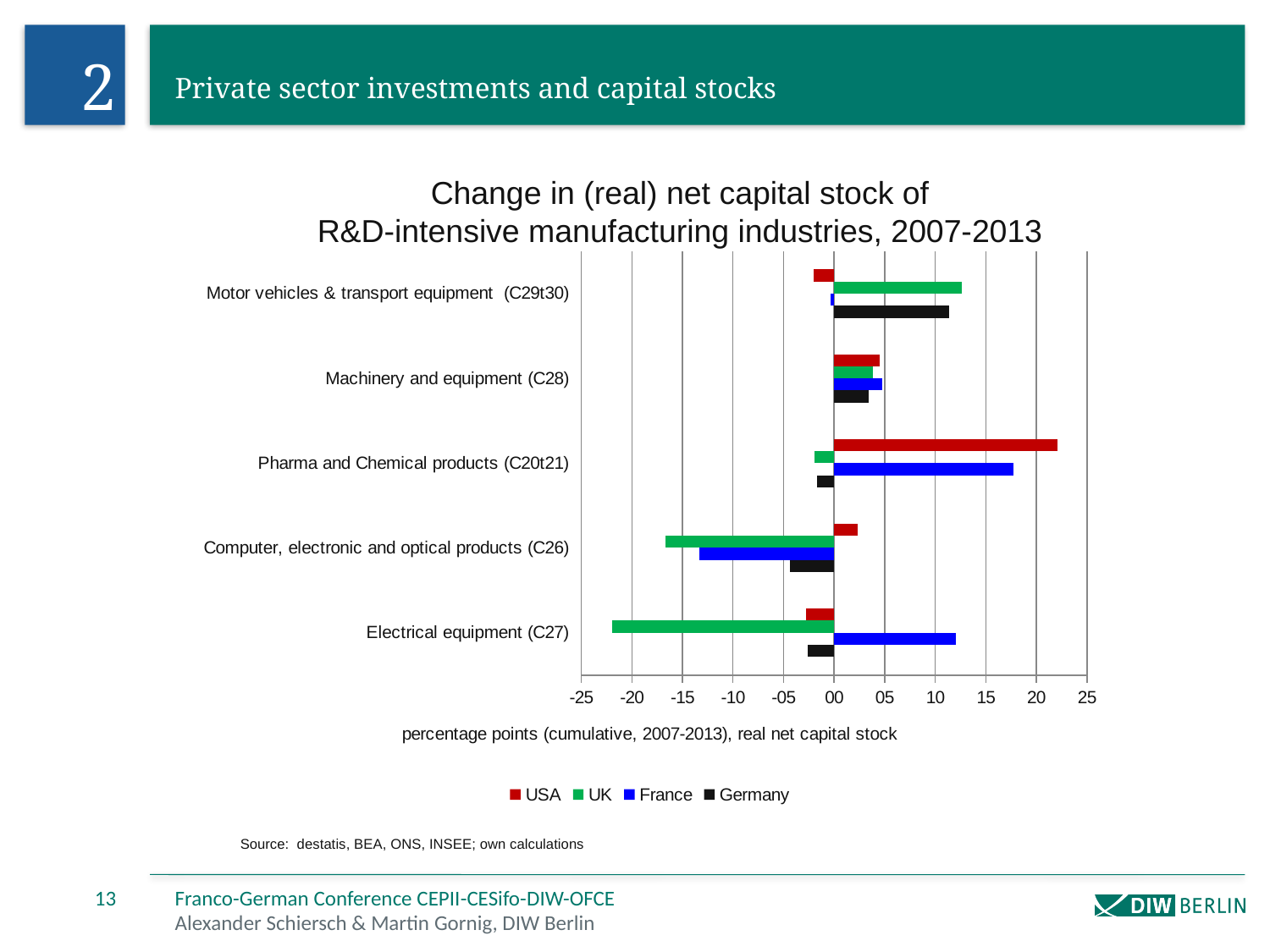
What kind of chart is shown on the slide? bar chart For Computer, electronic and optical products (C26), which series has the lowest value? UK For Pharma and Chemical products (C20t21), which is larger: the USA value or the France value? USA Which industry has the highest value for the USA? Pharma and Chemical products (C20t21) Is the USA value for Pharma and Chemical products (C20t21) greater or less than 20? greater Which industry has the lowest value for the UK? Electrical equipment (C27) Is the France value for Pharma and Chemical products (C20t21) greater or less than 15? greater How many industry categories are plotted on the chart? 5 Which colour represents Germany in the legend? black How many series does the legend list? 4 What is the title of the chart? Change in (real) net capital stock of R&D-intensive manufacturing industries, 2007-2013 Is the UK value for Electrical equipment (C27) greater or less than -20? less